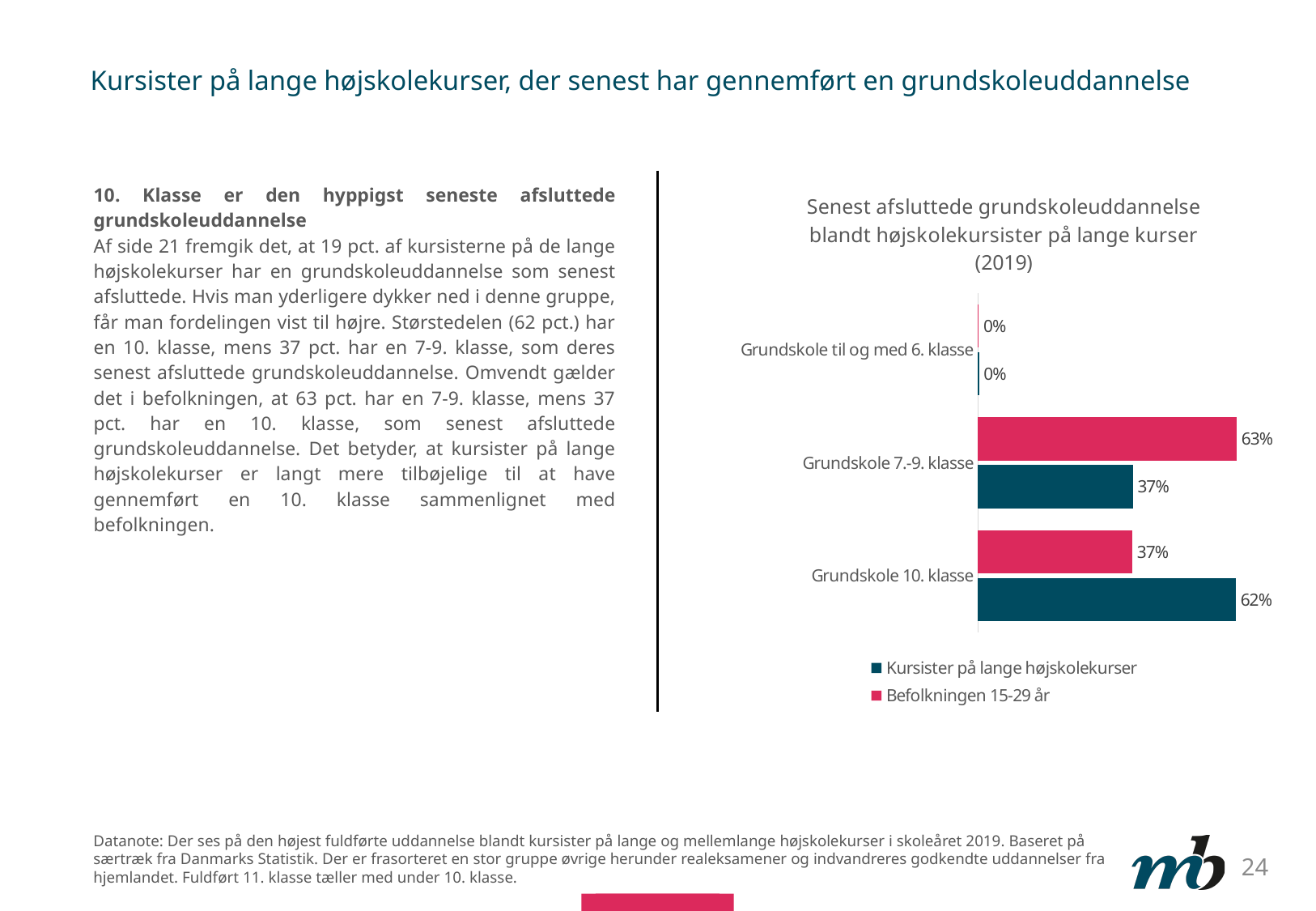
What is the value for Kursister på lange højskolekurser in the Grundskole 10. klasse category? 62% What is the value for Befolkningen 15-29 år in the Grundskole til og med 6. klasse category? 0% What kind of chart is shown on the slide? bar chart In the Grundskole 7.-9. klasse category, which series has the larger value: Kursister på lange højskolekurser or Befolkningen 15-29 år? Befolkningen 15-29 år What is the value for Kursister på lange højskolekurser in the Grundskole 7.-9. klasse category? 37% Which category has the highest value for Befolkningen 15-29 år? Grundskole 7.-9. klasse What is the title of the chart? Senest afsluttede grundskoleuddannelse blandt højskolekursister på lange kurser (2019) What is the difference between Kursister på lange højskolekurser and Befolkningen 15-29 år in the Grundskole 10. klasse category? 25% What is the value for Befolkningen 15-29 år in the Grundskole 7.-9. klasse category? 63% Which category has the highest value for Kursister på lange højskolekurser? Grundskole 10. klasse How many categories are shown on the chart? 3 How many series does the chart legend list? 2